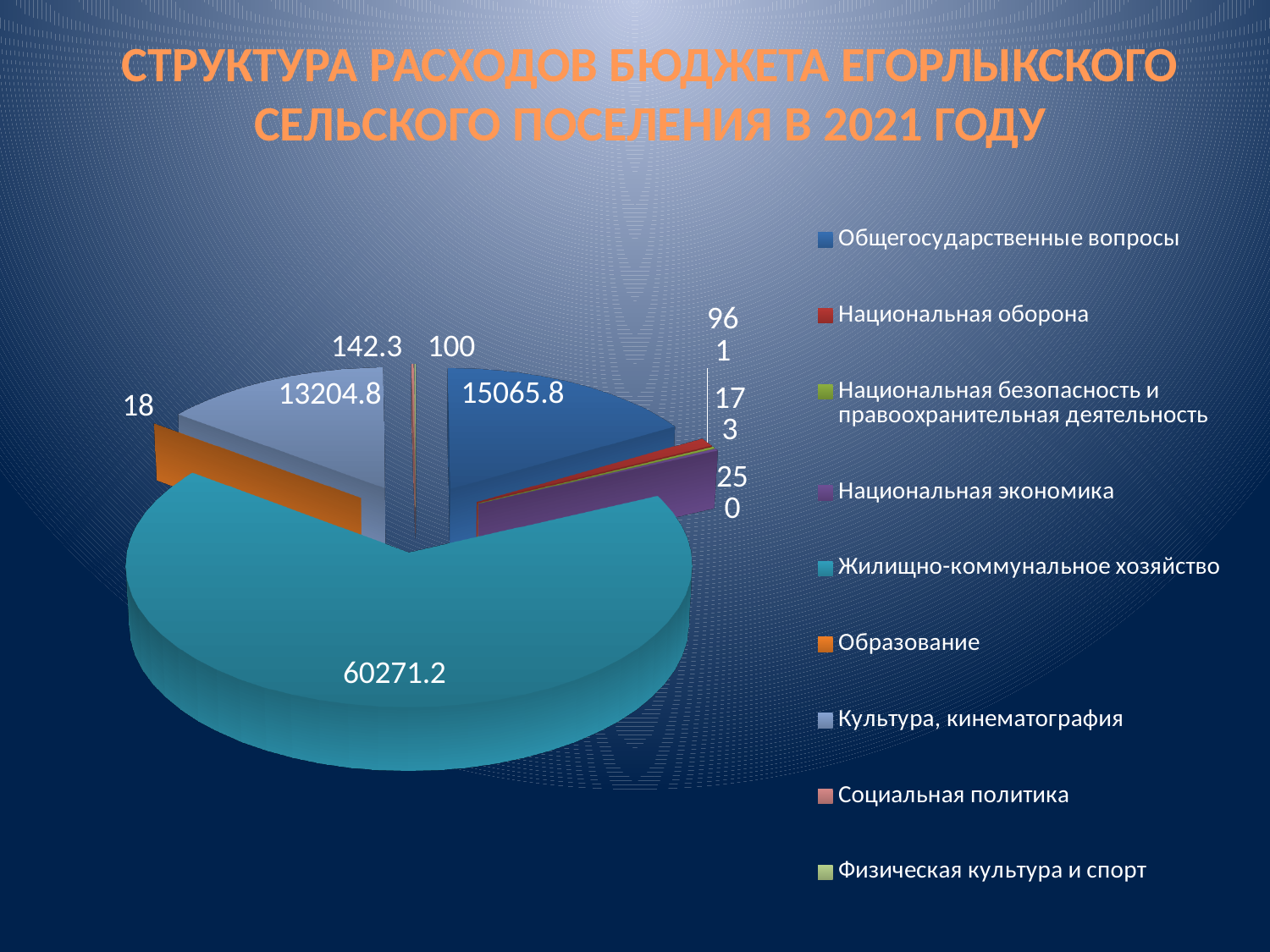
What is the title of the slide? Структура расходов бюджета Егорлыкского сельского поселения в 2021 году What is the difference between the values for Жилищно-коммунальное хозяйство and Общегосударственные вопросы? 45205.4 What is the value for Общегосударственные вопросы in the pie chart? 15065.8 What colour represents Образование in the legend? orange What type of chart is shown on the slide? pie chart Which category has the largest slice in the pie chart? Жилищно-коммунальное хозяйство What is the value for Социальная политика in the pie chart? 142.3 What is the value for Культура, кинематография in the pie chart? 13204.8 Which is larger: Общегосударственные вопросы or Культура, кинематография? Общегосударственные вопросы What is the value for Жилищно-коммунальное хозяйство in the pie chart? 60271.2 What is the difference between the values for Общегосударственные вопросы and Культура, кинематография? 1861 How many categories does the legend of the pie chart list? 9